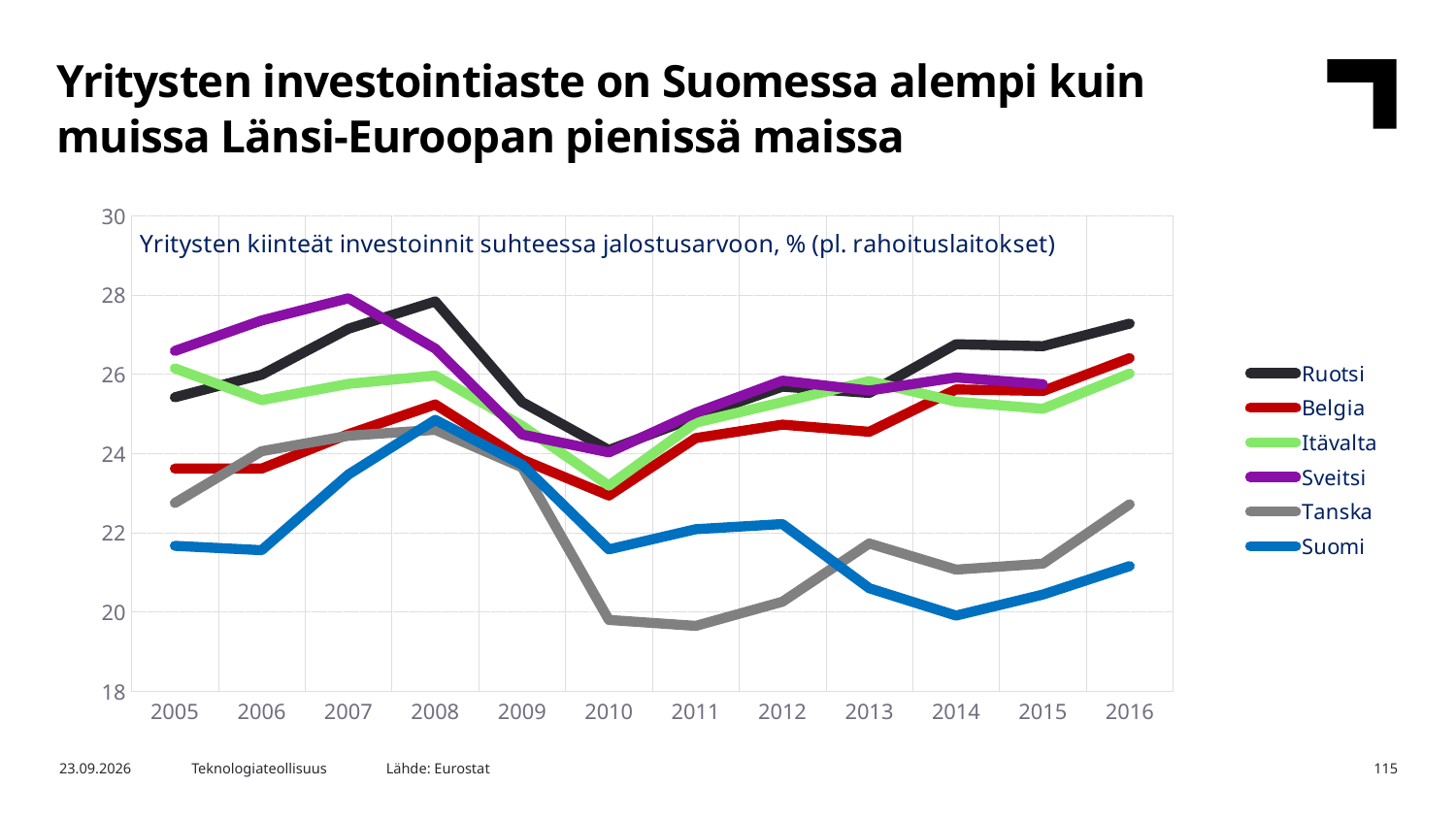
How many series does the legend list? 6 What kind of chart is shown on the slide? line chart Which country has the lowest value in 2011? Tanska Is the value for Tanska in 2011 greater or less than 22? less How many years are shown on the x axis? 12 In 2007, which is larger: the value for Sveitsi or the value for Suomi? Sveitsi Which country has the highest value in 2016? Ruotsi Is the value for Ruotsi in 2008 greater or less than 26? greater Does the value for Suomi rise or fall from 2012 to 2014? fall Which country has the lowest value in 2014? Suomi Is the value for Suomi in 2014 greater or less than 22? less What colour is the line for Suomi? blue